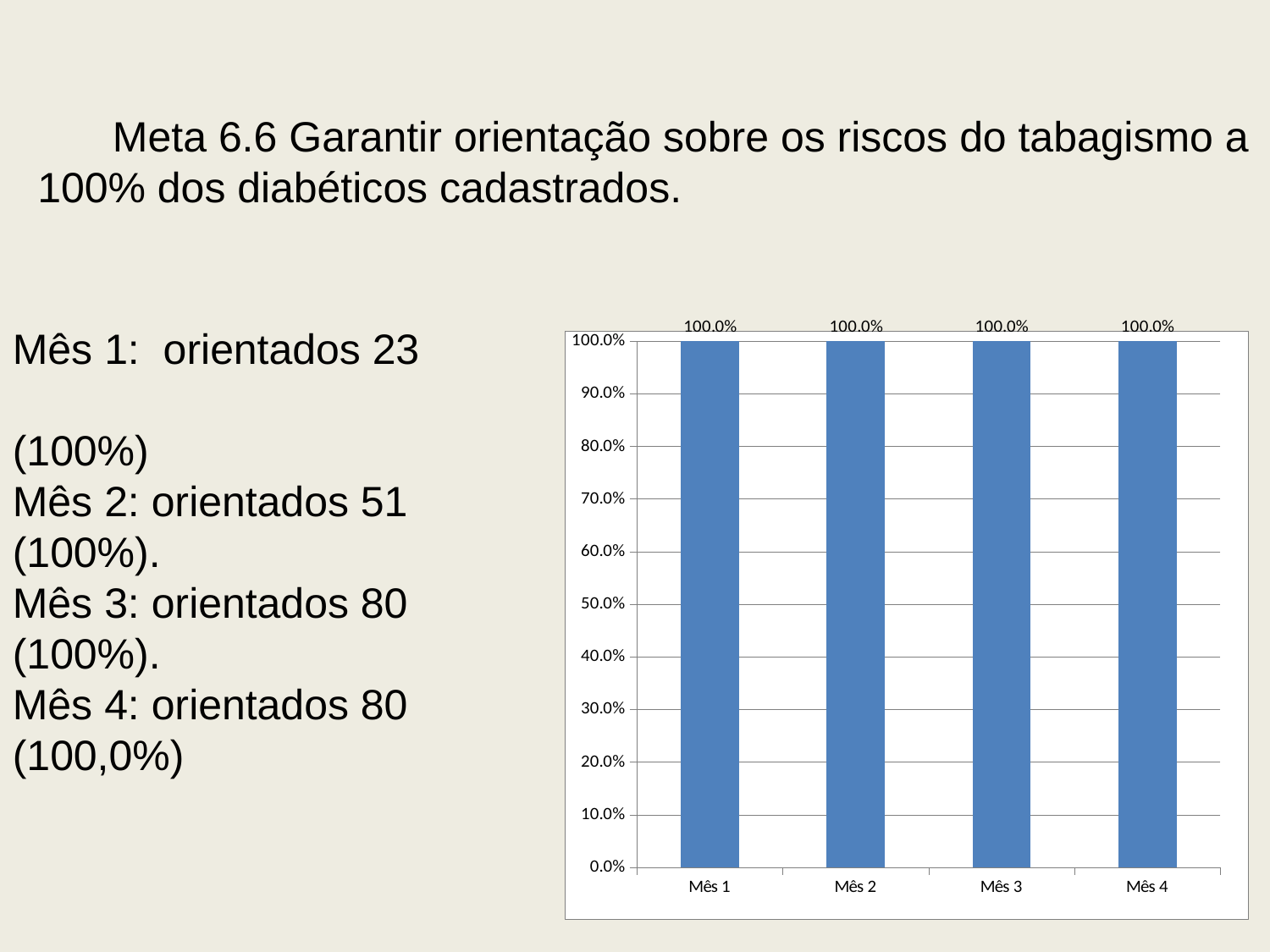
What kind of chart is shown on the slide? Bar chart Is the value for Mês 2 larger than, smaller than, or equal to the value for Mês 3? Equal What is the value shown for Mês 3 in the chart? 100.0% What colour are the bars in the chart? Blue Do the values rise, fall, or stay the same from Mês 1 to Mês 4? Stay the same What is the value shown for Mês 1 in the chart? 100.0% What is the value shown for Mês 4 in the chart? 100.0% How many categories (months) are plotted in the chart? 4 What is the difference between the values for Mês 1 and Mês 4? 0.0% What is the value shown for Mês 2 in the chart? 100.0% Is the value for Mês 3 greater or less than 50.0%? greater What is the highest value shown on the vertical axis of the chart? 100.0%